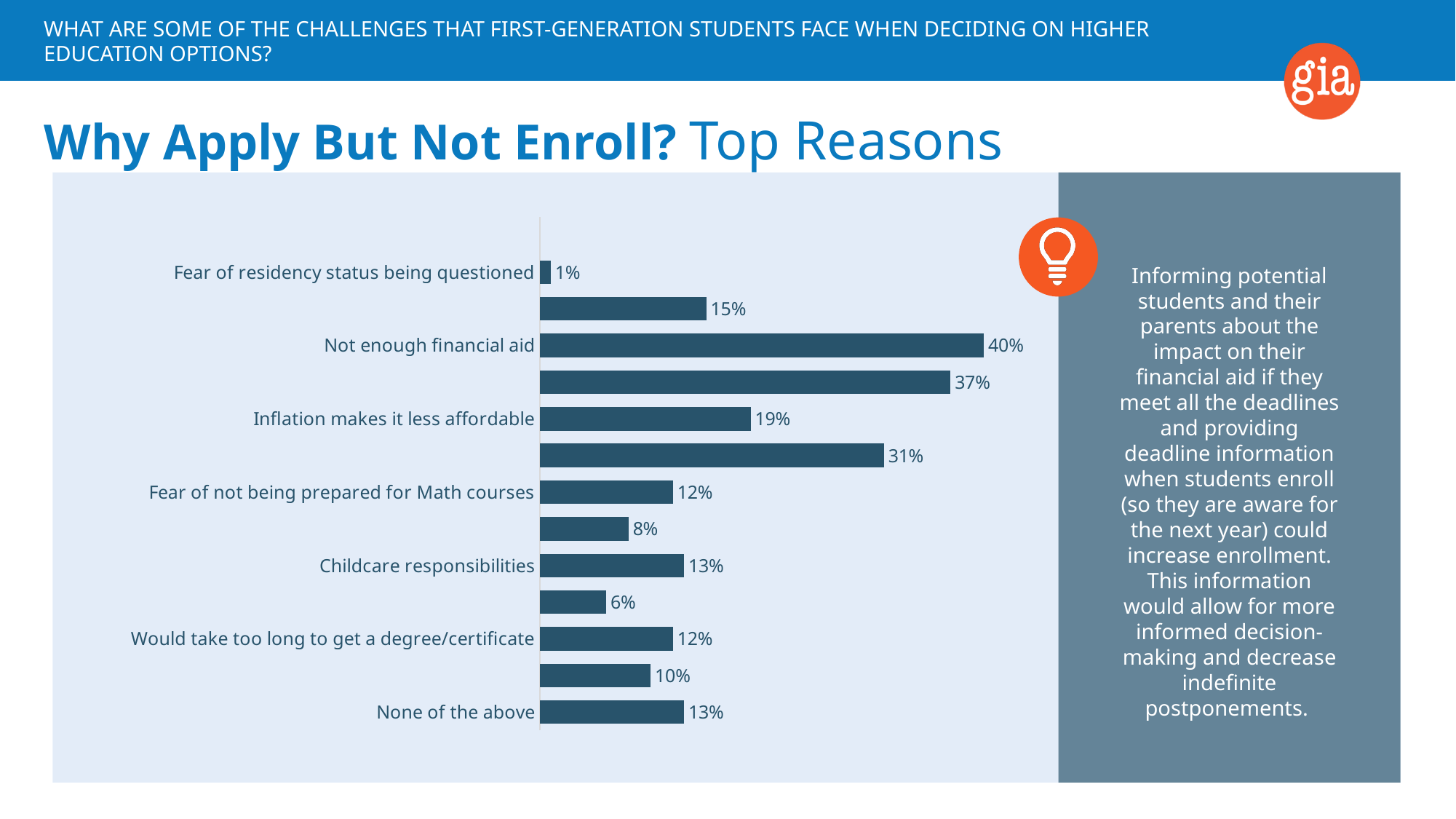
What percentage is shown for "Not enough financial aid"? 40% Which labeled reason has the highest percentage? Not enough financial aid What percentage is shown for "Childcare responsibilities"? 13% What percentage is shown for "Fear of residency status being questioned"? 1% What percentage is shown for "Inflation makes it less affordable"? 19% What percentage is shown for "Would take too long to get a degree/certificate"? 12% What is the difference between the percentages for "Not enough financial aid" and "Inflation makes it less affordable"? 21% Which is larger: the value for "Childcare responsibilities" or the value for "Fear of not being prepared for Math courses"? Childcare responsibilities What type of chart is shown on the slide? Bar chart Which labeled reason has the lowest percentage? Fear of residency status being questioned How many bars are plotted in the chart? 13 What is the title of the slide containing the chart? Why Apply But Not Enroll? Top Reasons